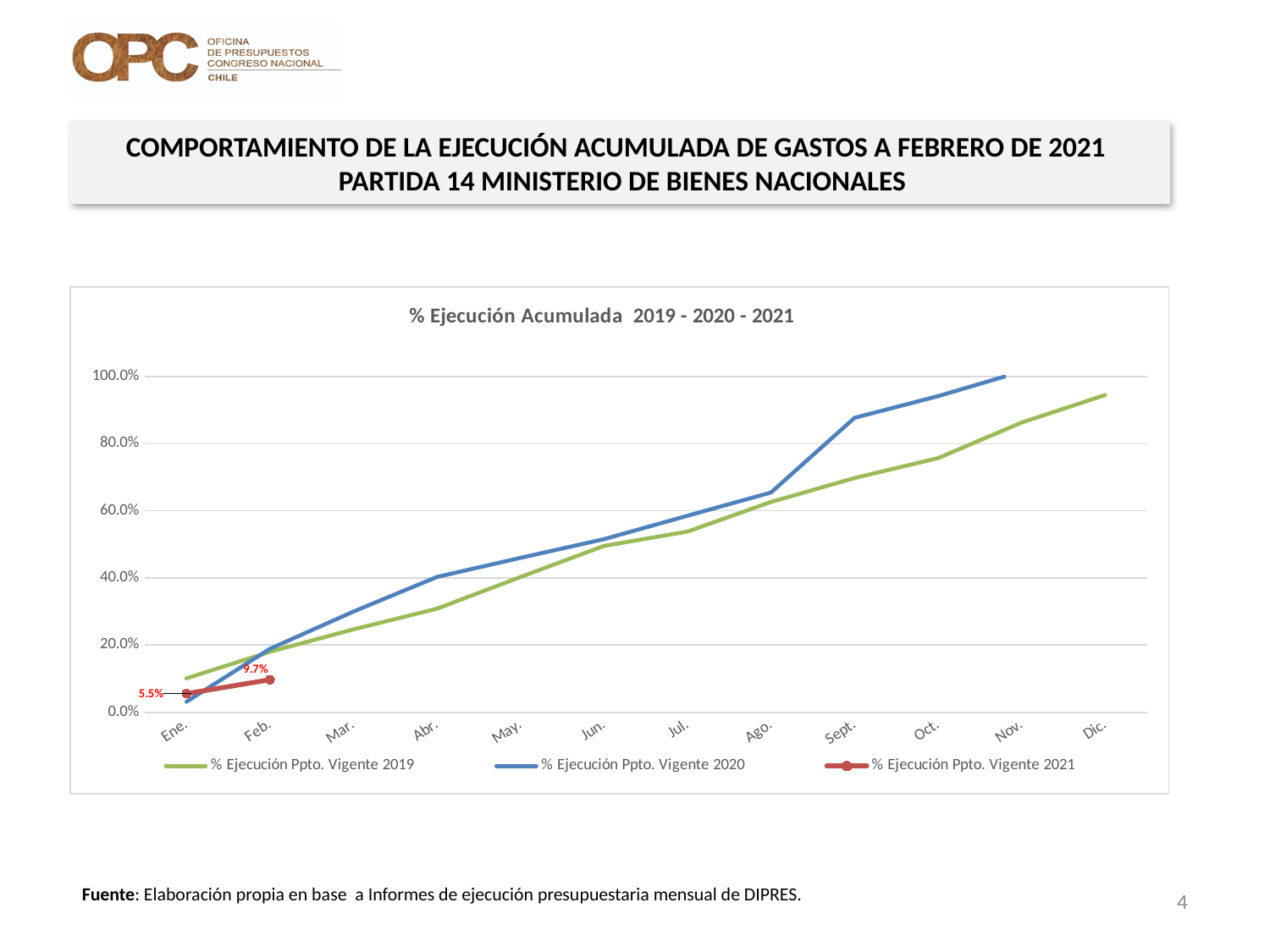
What kind of chart is shown on the slide? Line chart What is the title of the chart? % Ejecución Acumulada 2019 - 2020 - 2021 How many months are shown along the x axis? 12 What is the value of % Ejecución Ppto. Vigente 2021 for Ene.? 5.5% By how much did % Ejecución Ppto. Vigente 2021 increase from Ene. to Feb.? 4.2% What is the value of % Ejecución Ppto. Vigente 2021 for Feb.? 9.7% Is the value for % Ejecución Ppto. Vigente 2019 in Jun. greater or less than 60%? less How many series does the legend list? 3 In Sept., which series has the higher value: % Ejecución Ppto. Vigente 2019 or % Ejecución Ppto. Vigente 2020? % Ejecución Ppto. Vigente 2020 Is the value for % Ejecución Ppto. Vigente 2019 in Dic. greater or less than 80%? greater Does the % Ejecución Ppto. Vigente 2019 line rise or fall from Ene. to Dic.? Rise Is the value for % Ejecución Ppto. Vigente 2020 in Sept. greater or less than 80%? greater